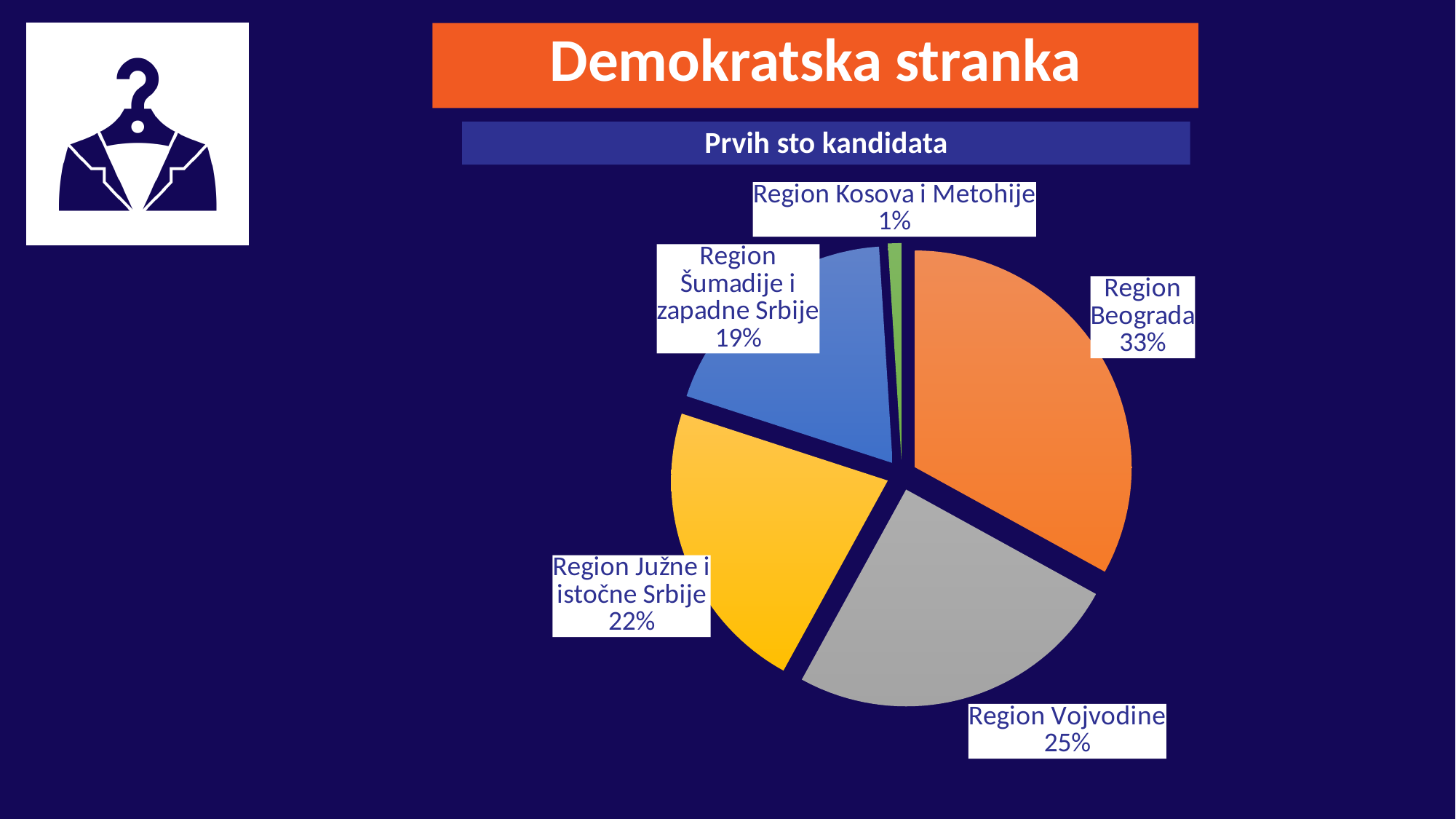
What share of the pie does Region Kosova i Metohije have? 1% What share of the pie does Region Šumadije i zapadne Srbije have? 19% What share of the pie does Region Beograda have? 33% What is the subtitle shown above the chart? Prvih sto kandidata Which is larger, the share for Region Vojvodine or the share for Region Južne i istočne Srbije? Region Vojvodine What share of the pie does Region Vojvodine have? 25% Which region has the largest slice of the pie? Region Beograda What share of the pie does Region Južne i istočne Srbije have? 22% What kind of chart is shown on the slide? Pie chart How many regions are shown in the pie chart? 5 Which region has the smallest slice of the pie? Region Kosova i Metohije What is the difference in percentage points between Region Beograda and Region Vojvodine? 8